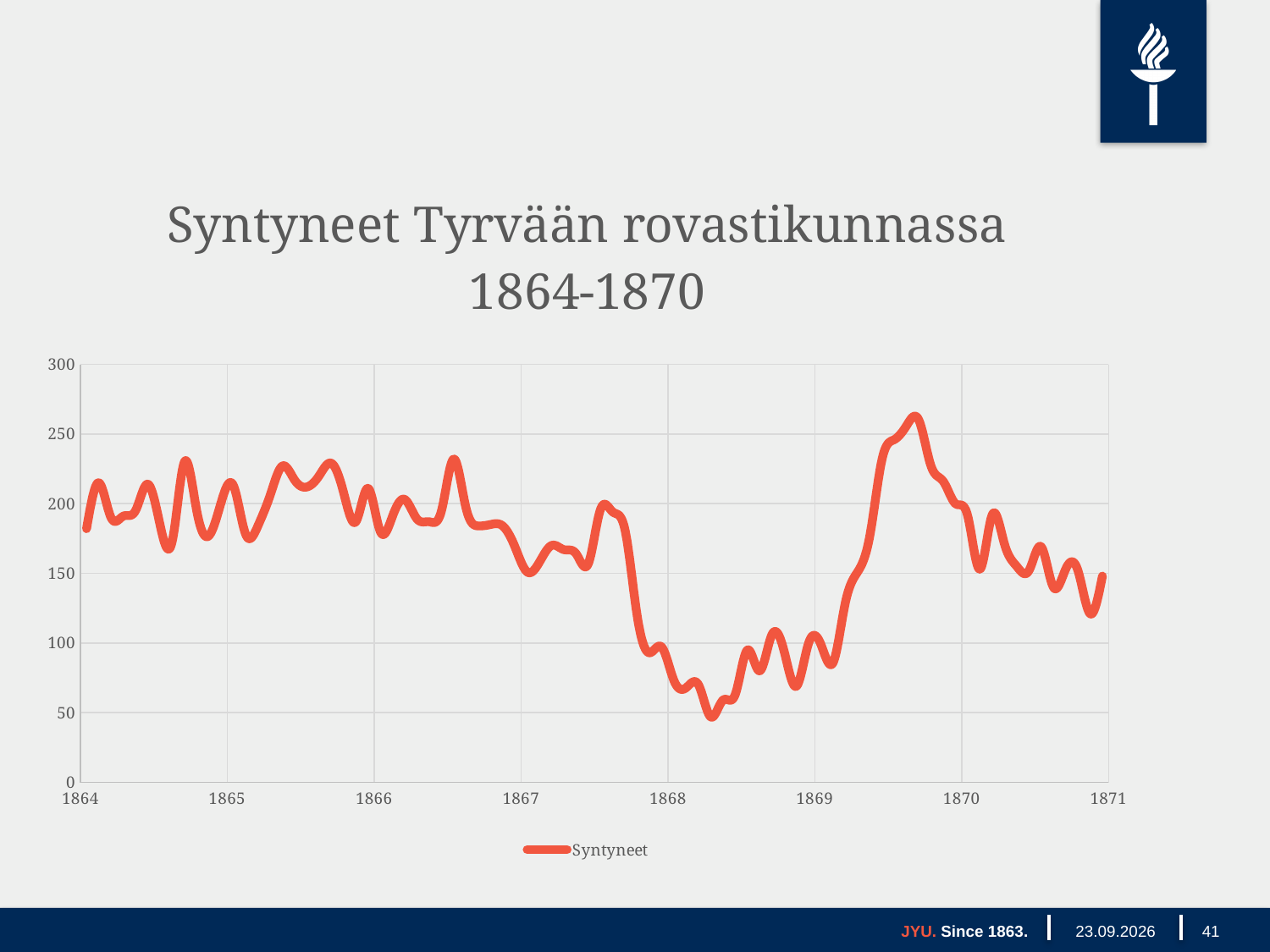
Is the value at the start of 1864 greater or less than 200? less In which year does the line reach its lowest point? 1868 What is the title of the chart? Syntyneet Tyrvään rovastikunnassa 1864-1870 Is the value at the start of 1865 greater or less than 150? greater What is the name of the series shown in the legend? Syntyneet Is the value at the start of 1870 greater or less than 150? greater How many series does the legend list? 1 In which year does the line reach its highest point? 1869 Between the start of 1867 and the start of 1868, do the values rise or fall? fall What kind of chart is shown on the slide? line chart